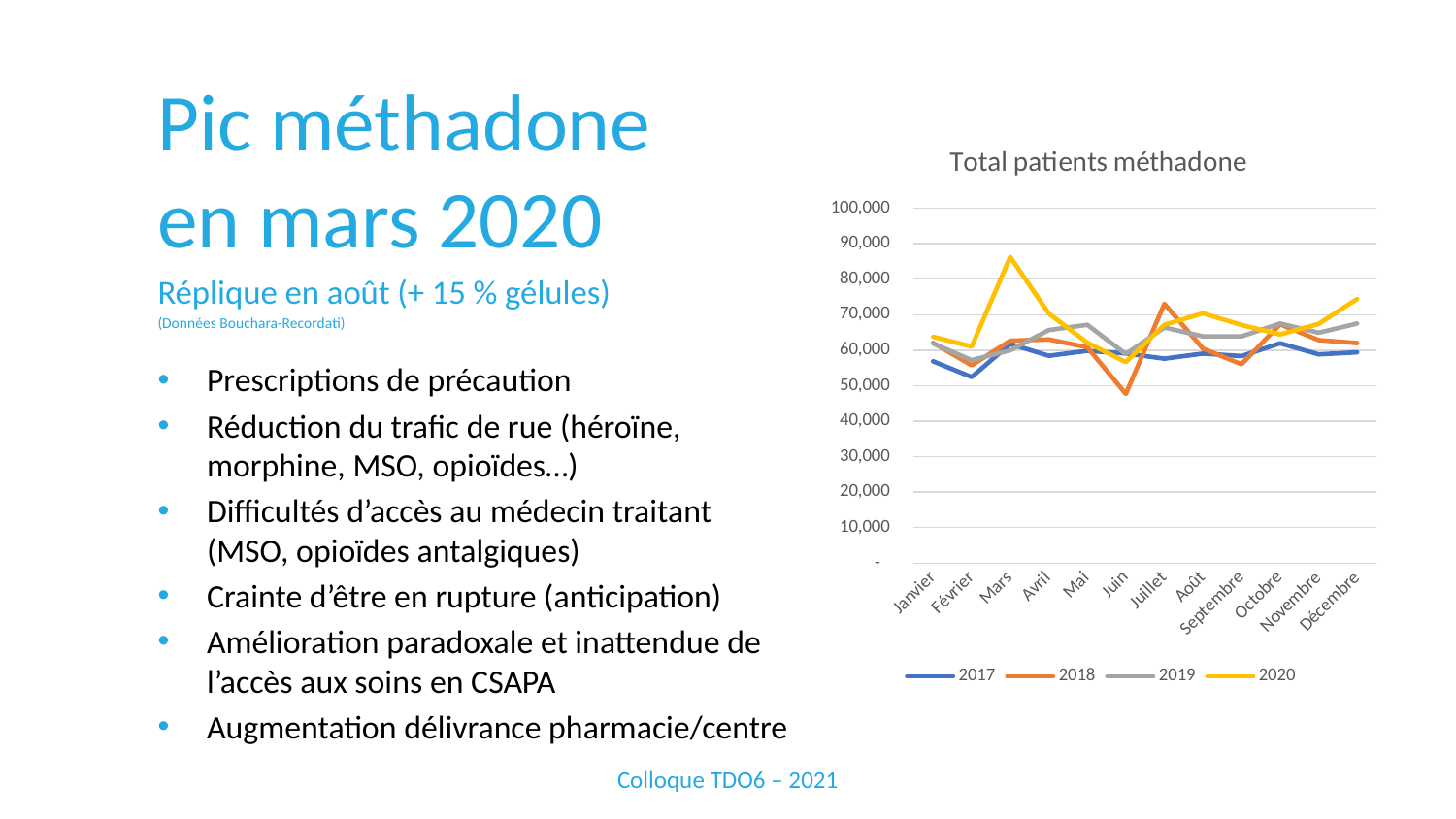
What is the title of the chart? Total patients méthadone In which month does the 2018 series reach its lowest value? Juin Is the value for 2018 in Juin greater or less than 60,000? less Which series has the larger value in Mars, 2017 or 2020? 2020 How many series does the chart legend list? 4 Which series has the larger value in Juillet, 2017 or 2018? 2018 How many months are shown along the x axis of the chart? 12 What kind of chart is shown on the slide? line chart In which month does the 2020 series reach its highest value? Mars Is the value for 2017 in Février greater or less than 60,000? less Is the value for 2020 in Mars greater or less than 80,000? greater Which colour is used for the 2020 series in the chart? yellow